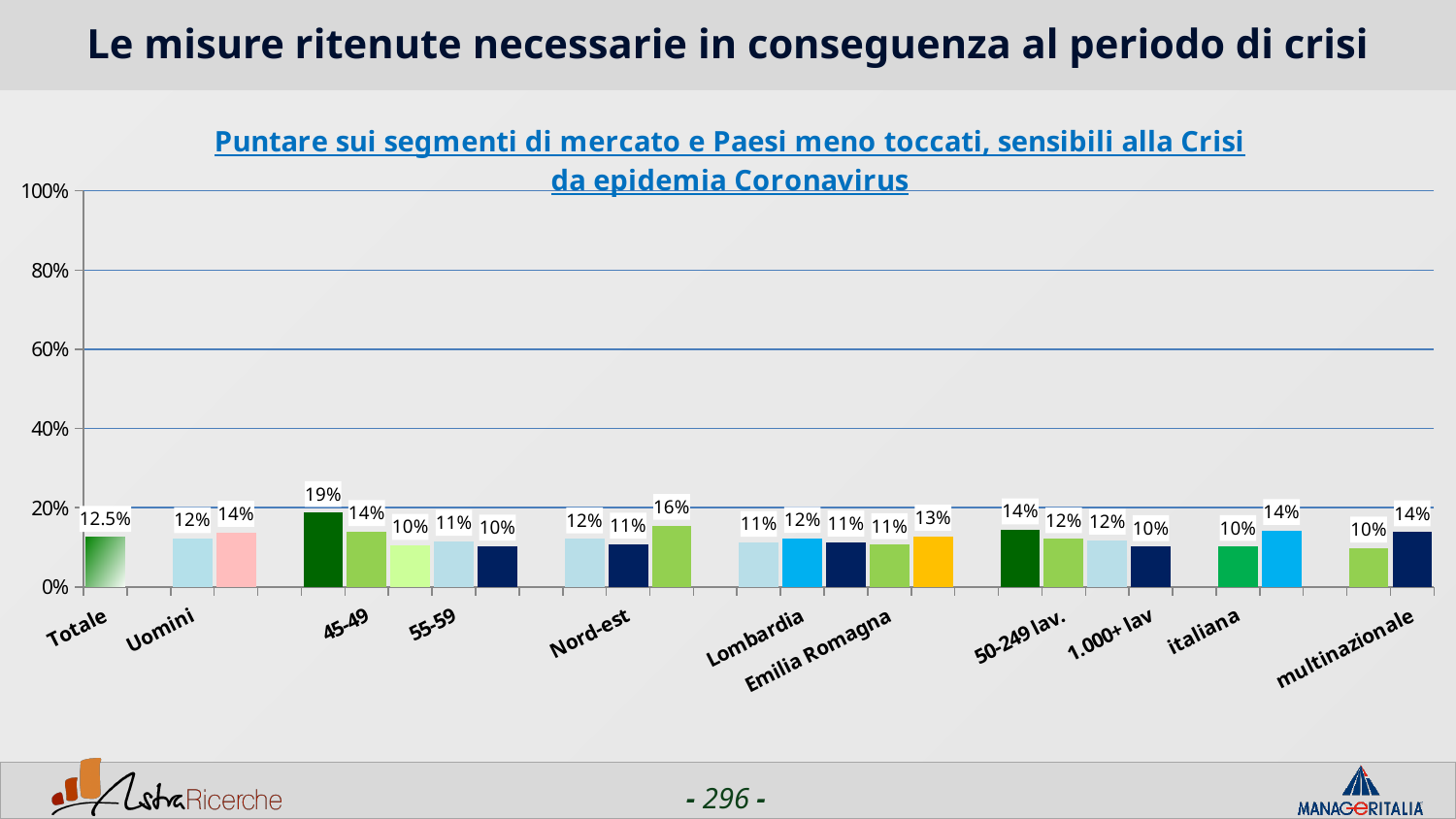
What kind of chart is shown on the slide? Bar chart What is the value for the 45-49 age group? 14% What is the value for Uomini? 12% What is the value for Lombardia? 12% What is the value for 1.000+ lav? 10% What is the value for multinazionale? 14% What is the value for the 55-59 age group? 11% Is the value for Totale greater or less than 20%? less Which is larger, the value for italiana or the value for multinazionale? multinazionale What is the value for Totale? 12.5% What is the value for Nord-est? 11% What is the difference between the values for multinazionale and italiana? 4 percentage points